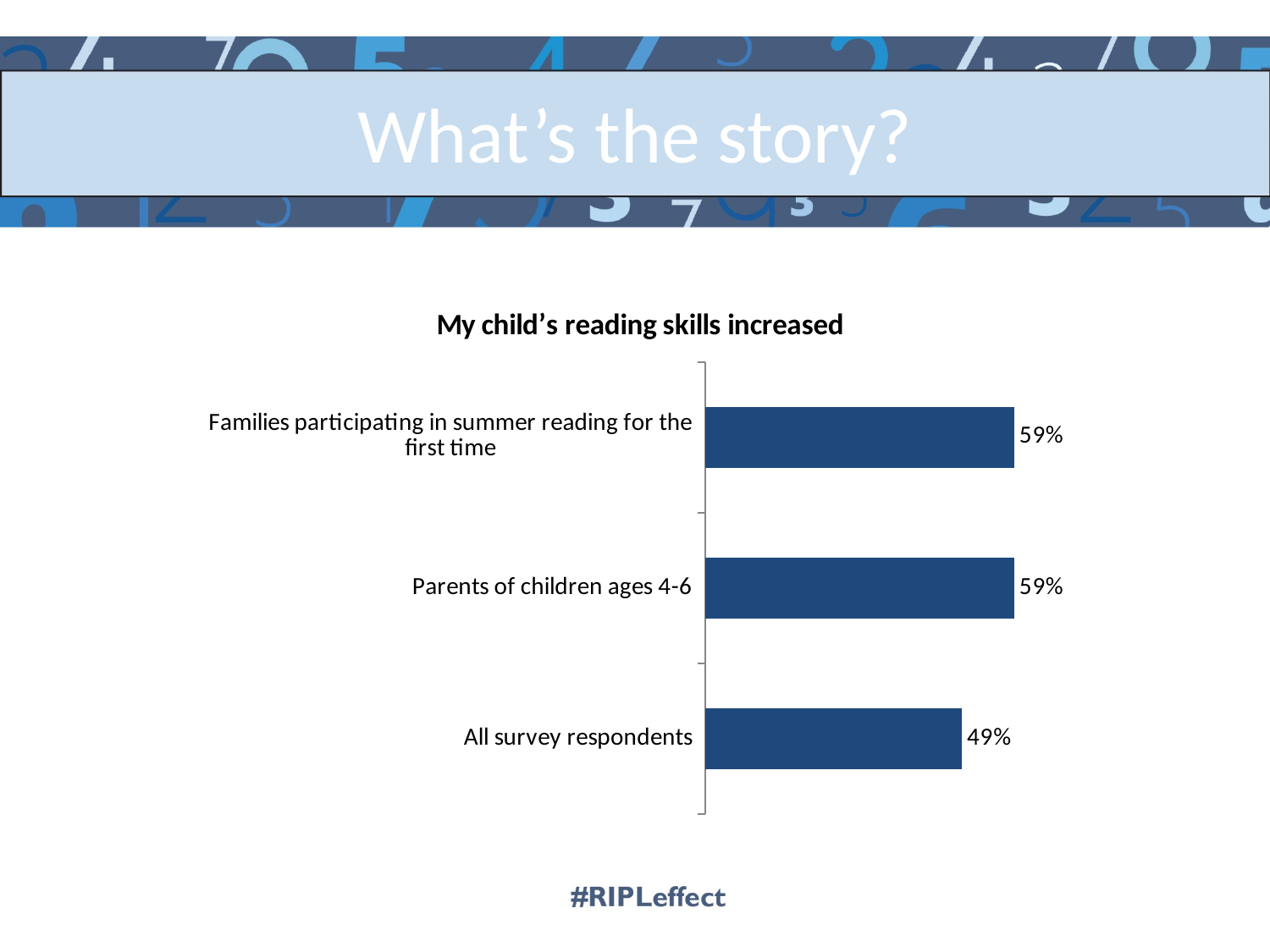
How many categories are shown in the chart? 3 What is the value for All survey respondents? 49% Which category has the lowest value? All survey respondents Are the bars in the chart horizontal or vertical? Horizontal Do Parents of children ages 4-6 and Families participating in summer reading for the first time have the same value? Yes What kind of chart is shown on the slide? Bar chart What is the difference between the value for Parents of children ages 4-6 and the value for All survey respondents? 10% What is the value for Families participating in summer reading for the first time? 59% What is the title of the chart? My child's reading skills increased What is the value for Parents of children ages 4-6? 59% Which is larger: the value for Families participating in summer reading for the first time or the value for All survey respondents? Families participating in summer reading for the first time